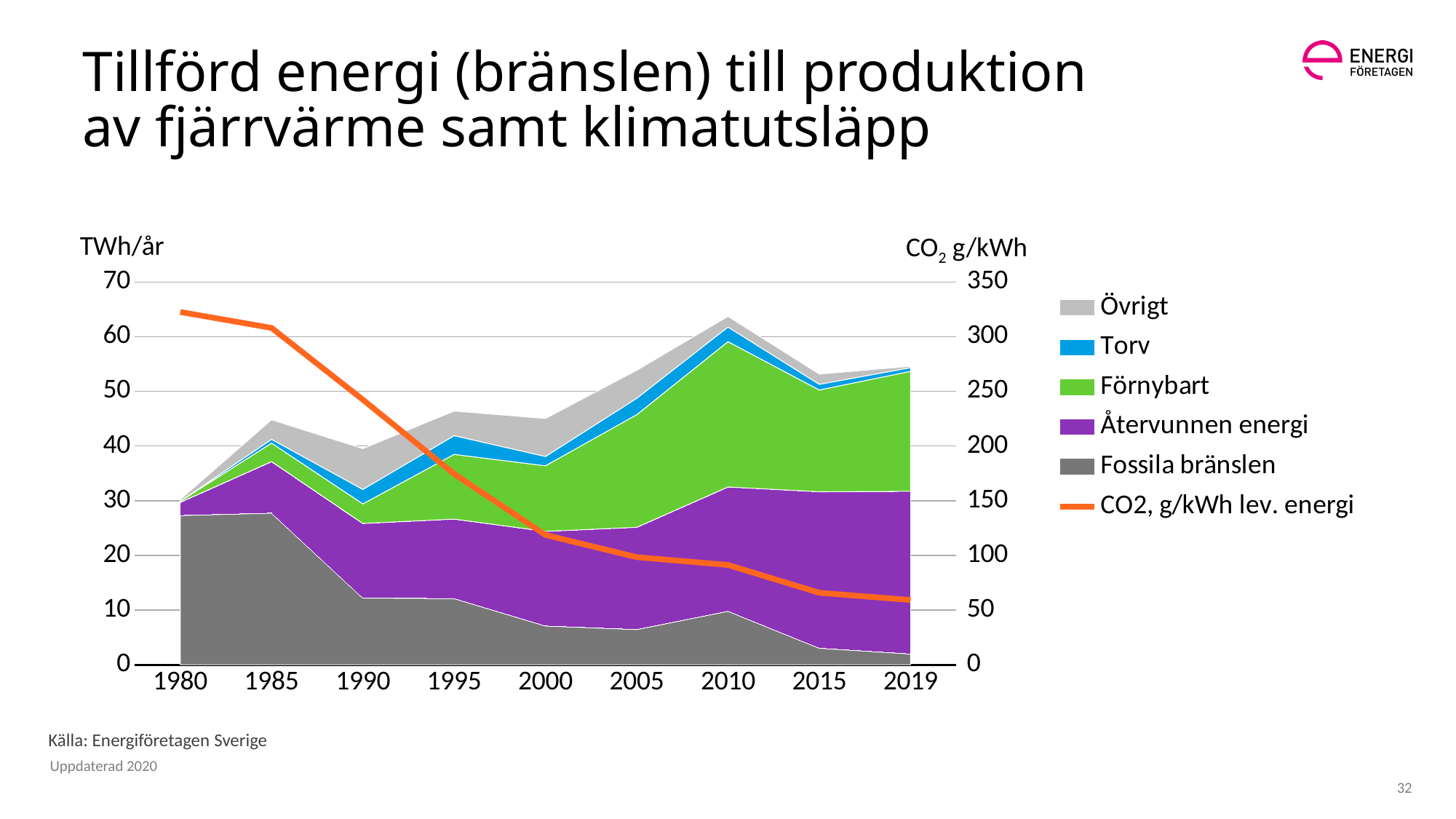
Which is larger, the Fossila bränslen value in 1980 or in 2019? 1980 How many years are shown on the x axis? 9 Is the total supplied energy (top of the stacked areas) in 2010 greater or less than 60 TWh/år? greater What unit is shown on the left vertical axis? TWh/år Is the value for Fossila bränslen in 2019 greater or less than 10 TWh/år? less Is the value of CO2, g/kWh lev. energi in 2019 greater or less than 100? less What kind of chart is shown on the slide? A stacked area chart with a line Does the CO2, g/kWh lev. energi line rise or fall from 1980 to 2019? Fall Which year has the highest value of CO2, g/kWh lev. energi? 1980 How many series does the legend list? 6